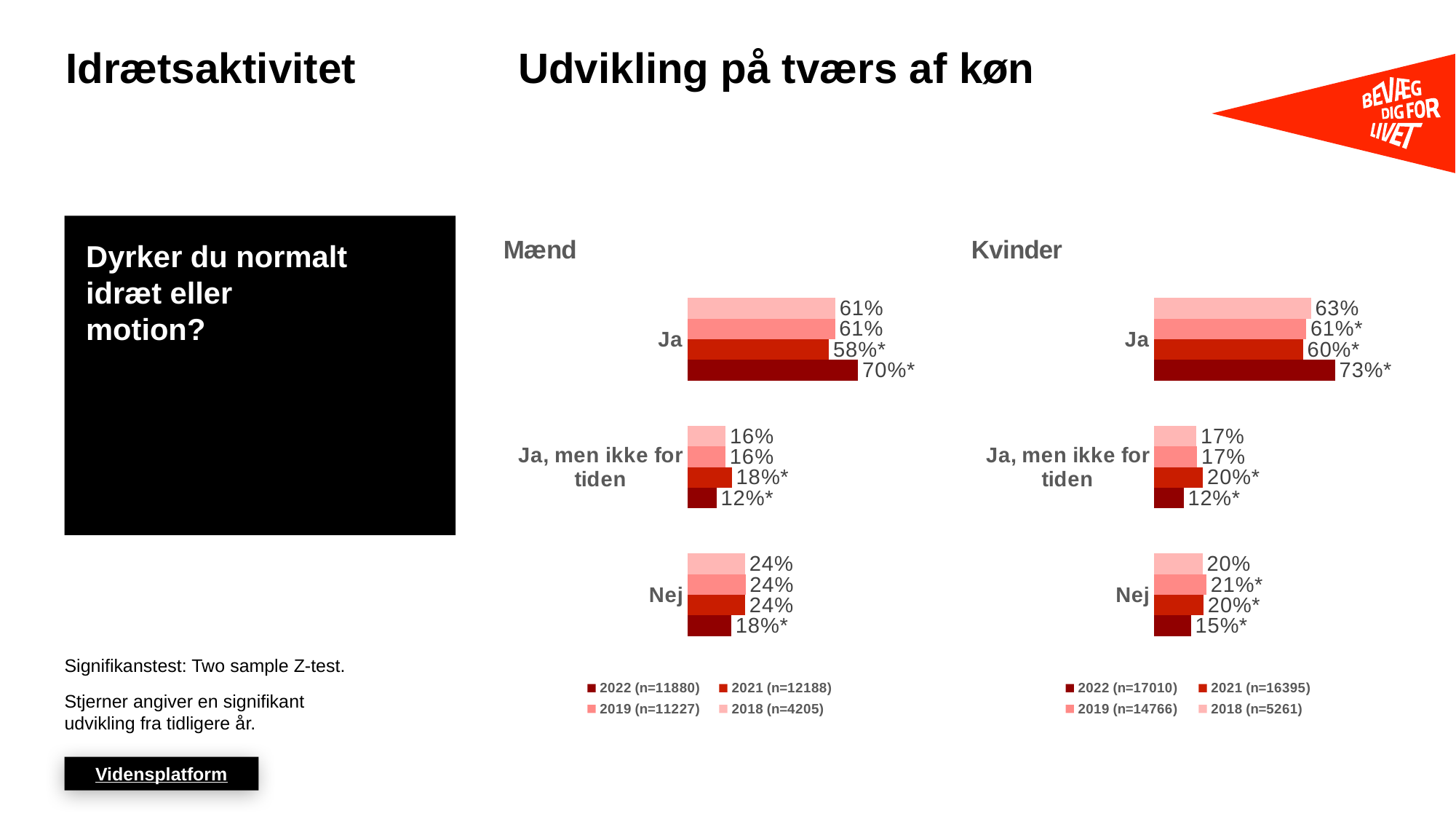
How many series does the legend of the Mænd chart list? 4 In the Kvinder chart, what is the value for 'Ja' in 2022? 73%* In the Kvinder chart, what is the value for 'Ja, men ikke for tiden' in 2021? 20%* In the Kvinder chart, what is the difference between the 2018 and 2022 values for 'Nej'? 5 percentage points In the Mænd chart, what is the value for 'Nej' in 2018? 24% In the Kvinder chart, which category has the lowest value in 2022? Ja, men ikke for tiden Which is larger: the 2022 'Ja' value in the Mænd chart or the 2022 'Ja' value in the Kvinder chart? Kvinder How many categories are shown in the Kvinder chart? 3 In the Mænd chart, what is the value for 'Ja' in 2022? 70%* What type of chart is the Mænd chart? Bar chart In the Mænd chart, which category has the highest value in 2022? Ja In the Mænd chart, what is the difference between the 2022 and 2021 values for 'Ja'? 12 percentage points